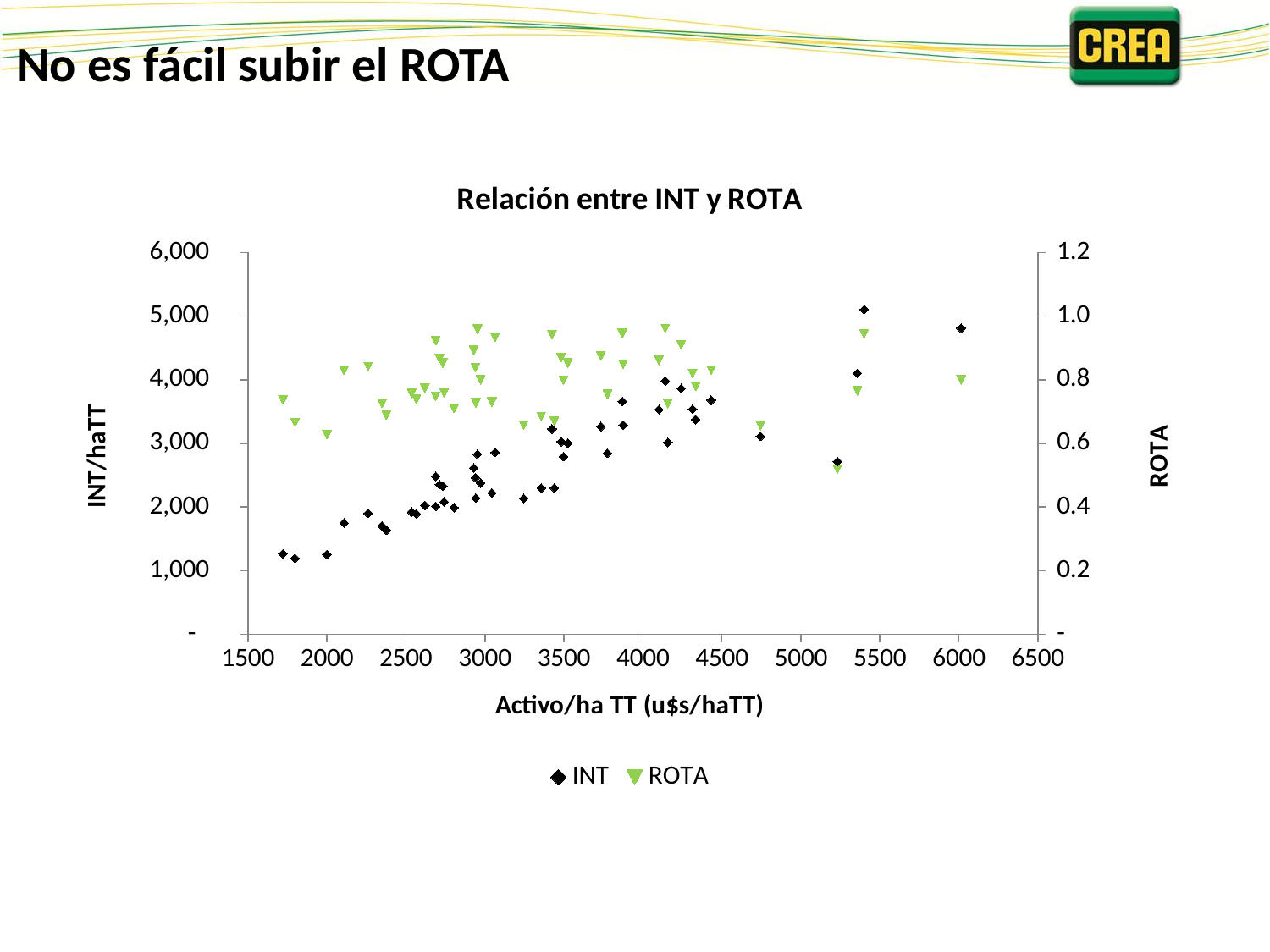
Do the INT values generally rise or fall as Activo/ha TT increases along the x axis? Rise What is the label of the horizontal axis? Activo/ha TT (u$s/haTT) What is the title of the chart? Relación entre INT y ROTA Is the ROTA value of the rightmost ROTA point (near 6000 on the x axis) greater or less than 0.6? greater What kind of chart is shown on the slide? Scatter chart Is the INT/haTT value of the leftmost INT point (near 1700 on the x axis) greater or less than 2,000? less Is the highest INT/haTT value plotted greater or less than 5,000? greater How many series does the legend list? 2